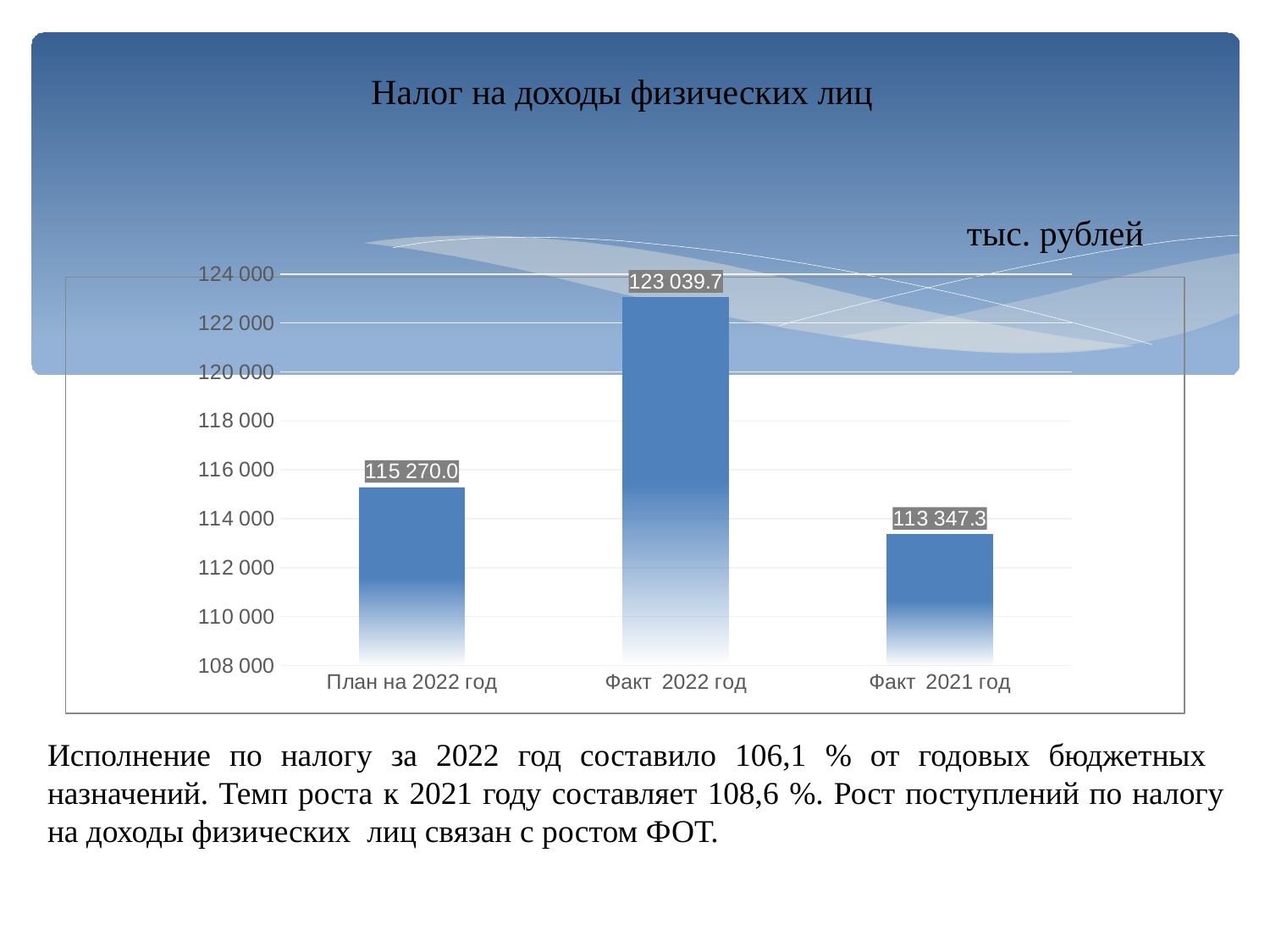
Which category has the lowest value? Факт 2021 год Is the value for Факт 2022 год greater or less than 120 000? greater Which is larger, План на 2022 год or Факт 2021 год? План на 2022 год What is the title of the chart? Налог на доходы физических лиц What is the value for План на 2022 год? 115 270.0 What is the difference between Факт 2022 год and План на 2022 год? 7 769.7 What kind of chart is shown on the slide? bar chart What is the value for Факт 2022 год? 123 039.7 What is the value for Факт 2021 год? 113 347.3 Which category has the highest value? Факт 2022 год What is the difference between Факт 2022 год and Факт 2021 год? 9 692.4 How many categories are shown in the chart? 3